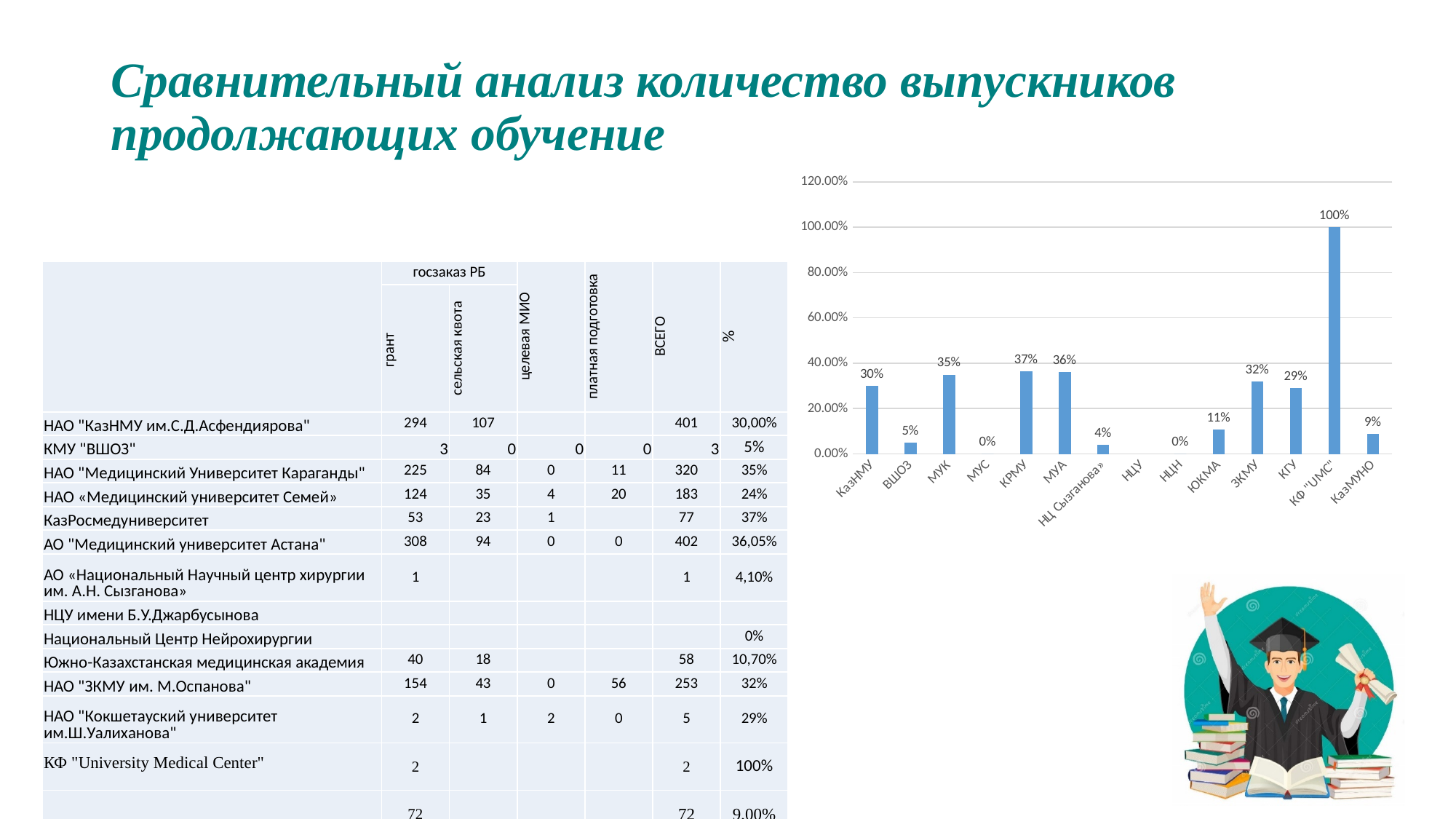
What is the value for КазМУНО in the chart? 9% Is the value for КФ "UMC" greater or less than 80.00% on the chart's axis? greater Which category has the highest value in the chart? КФ "UMC" How many categories are shown on the x axis of the chart? 14 What is the value for КазНМУ in the chart? 30% What is the highest tick value shown on the chart's vertical axis? 120.00% What is the value for КРМУ in the chart? 37% What type of chart is shown on the slide? bar chart What is the difference between the values for ЗКМУ and КГУ in the chart? 3% What is the value for ЮКМА in the chart? 11% What is the difference between the values for КФ "UMC" and МУА in the chart? 64% Which is larger in the chart, the value for МУК or the value for ВШОЗ? МУК